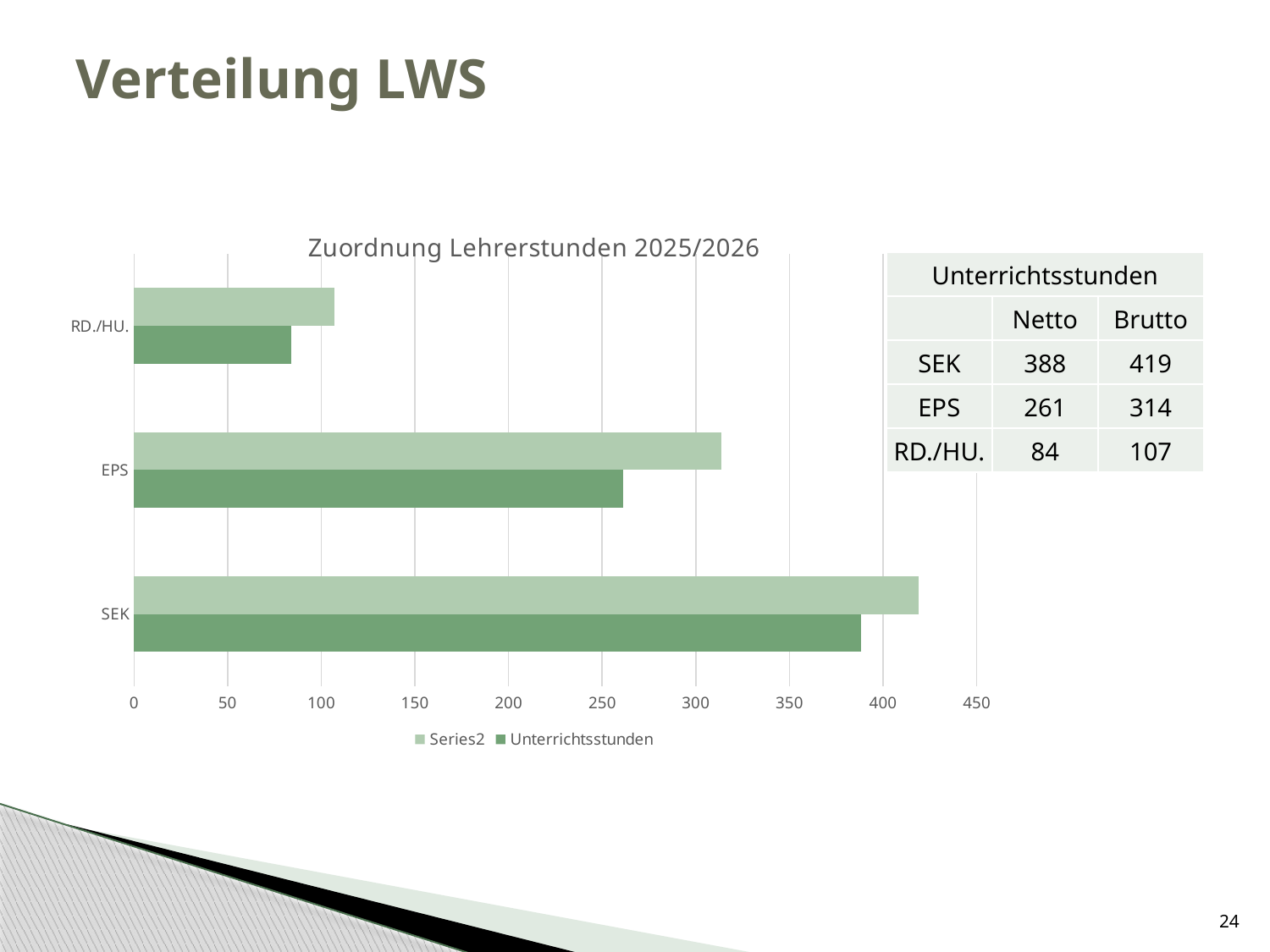
Is the Unterrichtsstunden value for SEK greater or less than 350? greater Which category has the longest bars in the chart? SEK Is the Series2 value for RD./HU. greater or less than 150? less What is the title of the chart? Zuordnung Lehrerstunden 2025/2026 According to the table on the slide, what is the Brutto value for RD./HU. plotted in the chart? 107 According to the table on the slide, what is the Unterrichtsstunden (Netto) value for SEK plotted in the chart? 388 Which category has the shortest bars in the chart? RD./HU. How many categories are shown on the chart's vertical axis? 3 How many series does the chart legend list? 2 Is the Unterrichtsstunden value for EPS greater or less than 250? greater What kind of chart is shown on the slide? bar chart Which is larger for EPS: the Series2 bar or the Unterrichtsstunden bar? Series2